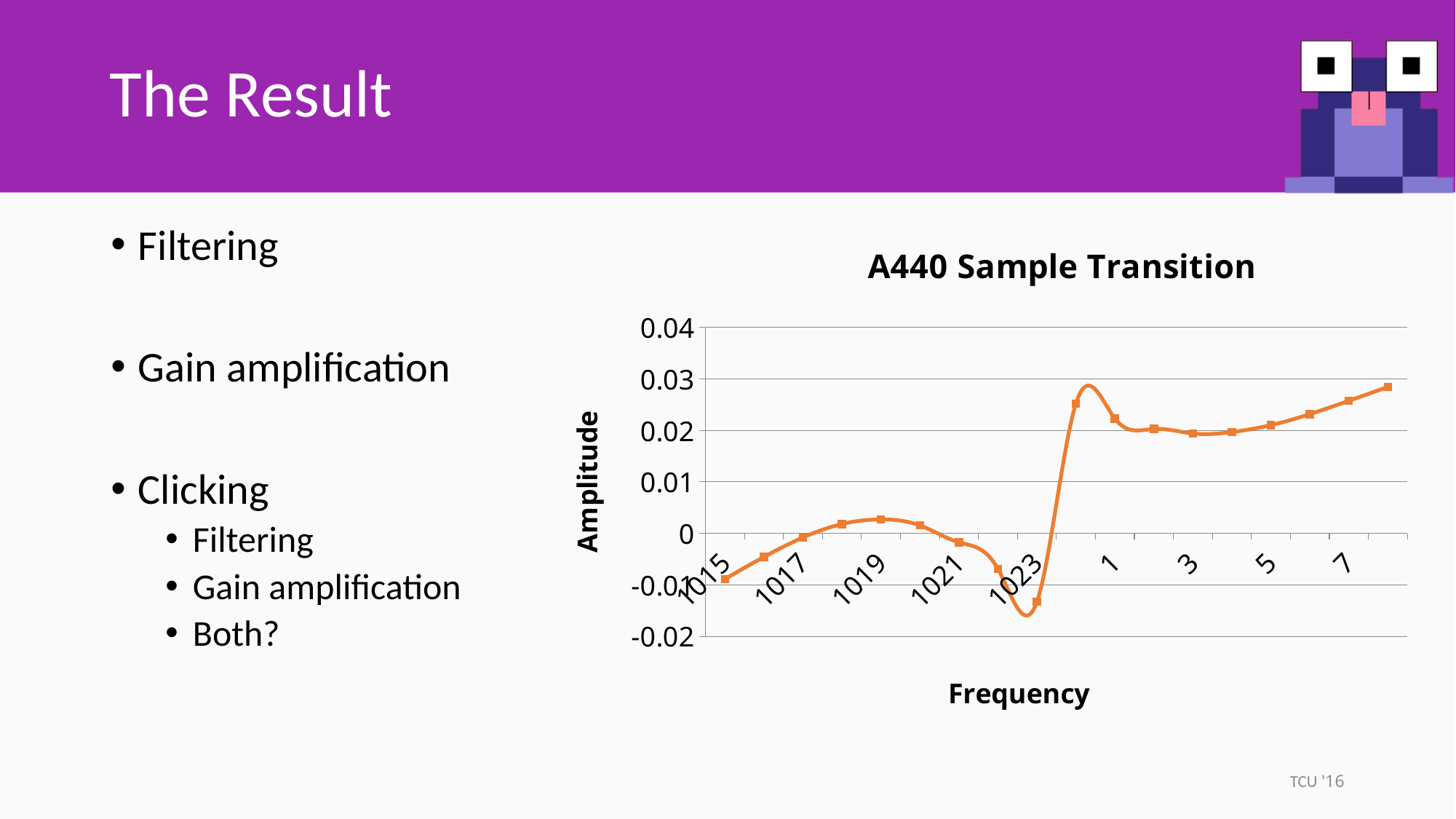
Which has the larger amplitude, 1019 or 1023? 1019 Is the value for 3 greater or less than 0.01? greater What kind of chart is shown on the slide? line chart Which labeled frequency has the lowest amplitude? 1023 Is the value for 7 greater or less than 0.02? greater What is the title of the chart? A440 Sample Transition Which has the larger amplitude, 7 or 1015? 7 Is the value for 1023 greater or less than -0.01? less Do the values rise or fall from 3 to 7 along the x axis? rise What is the label of the vertical axis? Amplitude